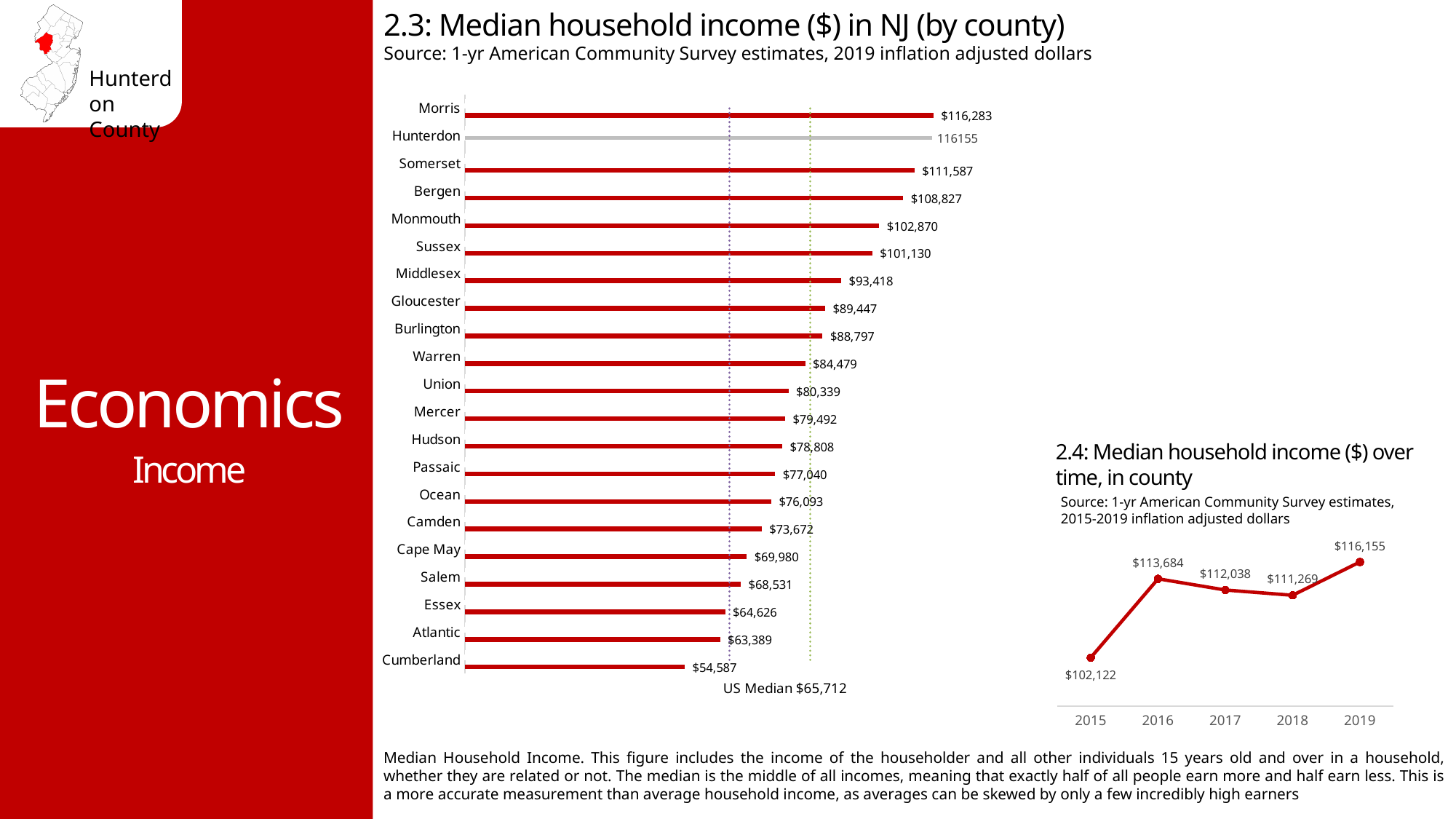
In chart 2.3 (Median household income in NJ by county), what is the median household income for Somerset? $111,587 In chart 2.3 (Median household income in NJ by county), what is the median household income for Cumberland? $54,587 What kind of chart is chart 2.3 (Median household income in NJ by county)? Bar chart In chart 2.4 (Median household income over time, in county), does the median household income rise or fall from 2015 to 2016? Rise In chart 2.3 (Median household income in NJ by county), which county has a higher median household income, Bergen or Monmouth? Bergen In chart 2.4 (Median household income over time, in county), which year has the highest median household income? 2019 In chart 2.3 (Median household income in NJ by county), how many counties are shown? 21 In chart 2.4 (Median household income over time, in county), what is the median household income in 2017? $112,038 In chart 2.3 (Median household income in NJ by county), what is the difference between the median household income of Morris and Cumberland? $61,696 In chart 2.4 (Median household income over time, in county), what is the difference between the 2019 and 2015 values? $14,033 In chart 2.3 (Median household income in NJ by county), which county has the lowest median household income? Cumberland In chart 2.3 (Median household income in NJ by county), which county has the highest median household income? Morris